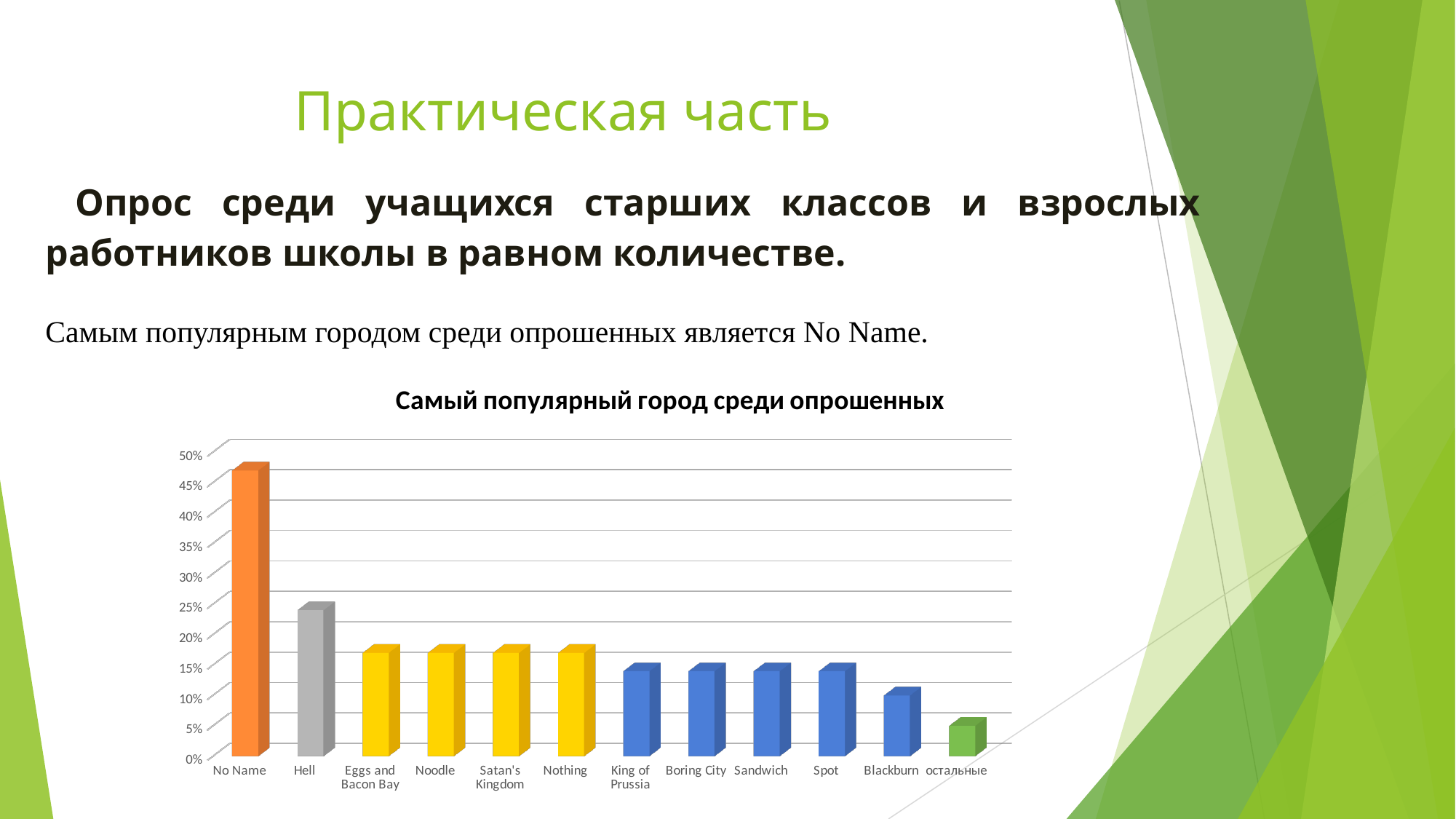
Is the value for Hell greater or less than 20%? greater Which is larger, the value for Blackburn or the value for Spot? Spot Is the value for No Name greater or less than 40%? greater Which is larger, the value for Hell or the value for Noodle? Hell Is the value for Eggs and Bacon Bay greater or less than 20%? less Which category has the lowest value in the chart? остальные Which category has the highest value in the chart? No Name How many categories are shown on the x axis of the chart? 12 What is the title of the chart? Самый популярный город среди опрошенных What kind of chart is shown on the slide? bar chart